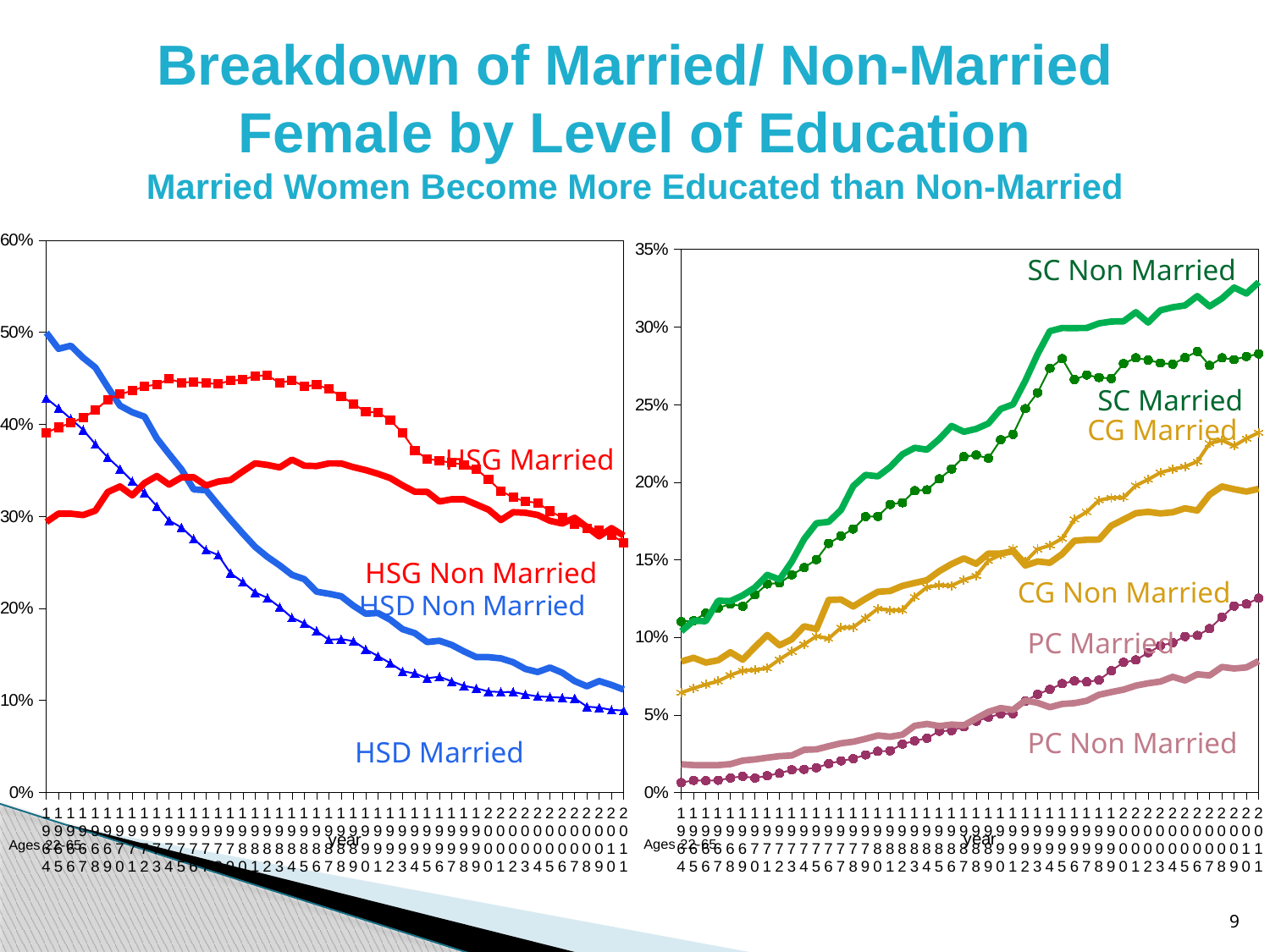
On the right chart, do the SC Non Married values generally rise or fall from 1964 to 2011? rise On the left chart, do the HSD Non Married values generally rise or fall from 1964 to 2011? fall How many series are labelled on the left chart? 4 What kind of chart is the left chart on the slide? line chart How many series are labelled on the right chart? 6 On the right chart, is the value for PC Non Married in 2011 greater or less than 10%? less On the right chart, which series has the lowest value at the end of the period (2011)? PC Non Married What is the highest value shown on the y axis of the left chart? 60% On the right chart, is the value for SC Non Married in 2011 greater or less than 30%? greater On the right chart, which is larger in 2011: SC Married or CG Married? SC Married On the left chart, are the HSG Married and HSG Non Married values in 2011 greater or less than 30%? less On the right chart, which series has the highest value at the end of the period (2011)? SC Non Married